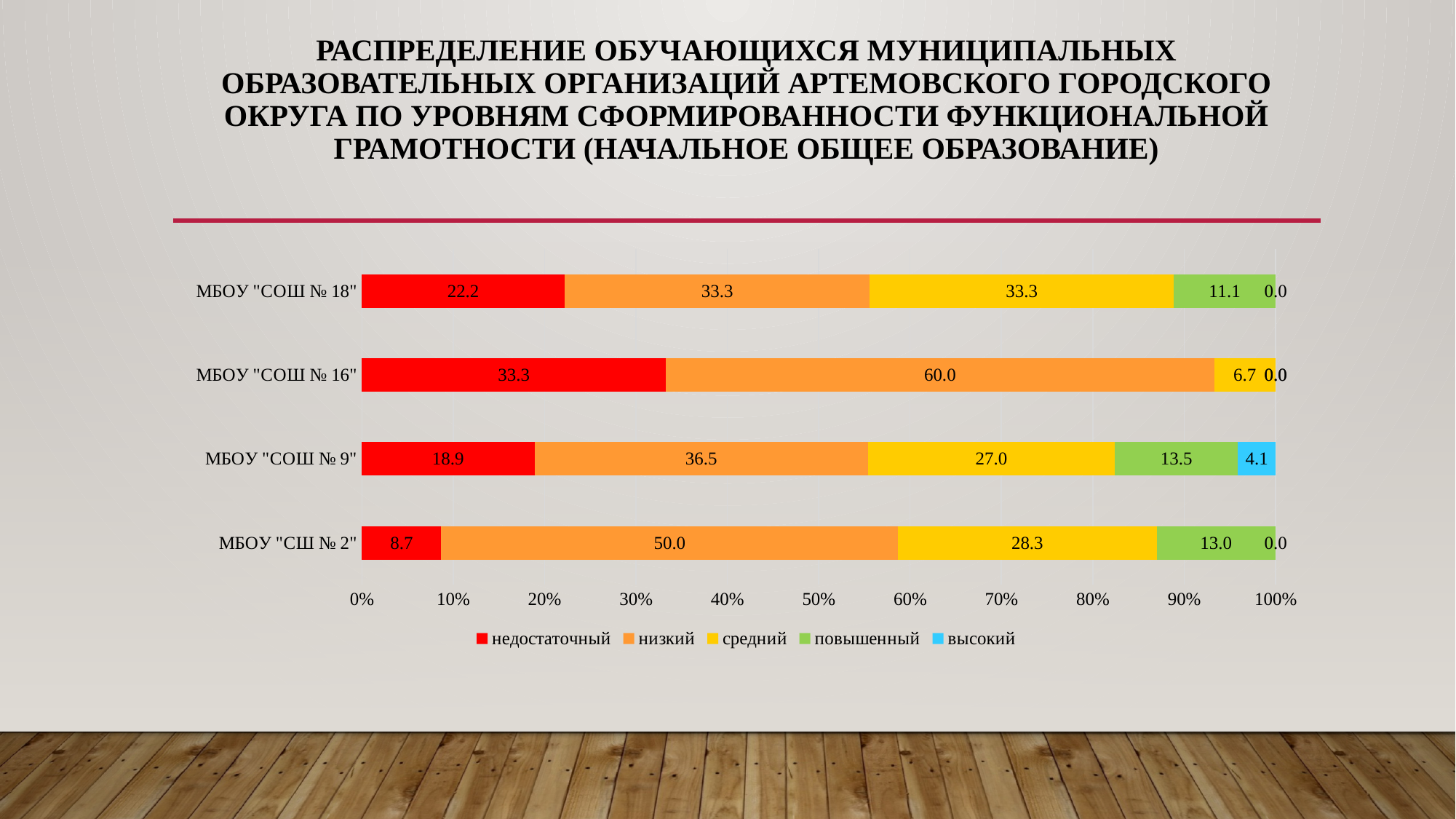
Which school has the highest value for the "недостаточный" series? МБОУ "СОШ № 16" Which school has the lowest value for the "недостаточный" series? МБОУ "СШ № 2" How many schools are shown on the chart? 4 How many series does the legend list? 5 Which has the larger "повышенный" value, МБОУ "СОШ № 9" or МБОУ "СШ № 2"? МБОУ "СОШ № 9" What is the difference between the "средний" values for МБОУ "СОШ № 18" and МБОУ "СОШ № 16"? 26.6 What kind of chart is shown on the slide? Stacked bar chart What is the value of the "низкий" series for МБОУ "СОШ № 16"? 60.0 What colour represents the "высокий" series in the legend? Blue What is the value of the "высокий" series for МБОУ "СОШ № 9"? 4.1 What is the difference between the "низкий" values for МБОУ "СШ № 2" and МБОУ "СОШ № 9"? 13.5 What is the value of the "недостаточный" series for МБОУ "СШ № 2"? 8.7